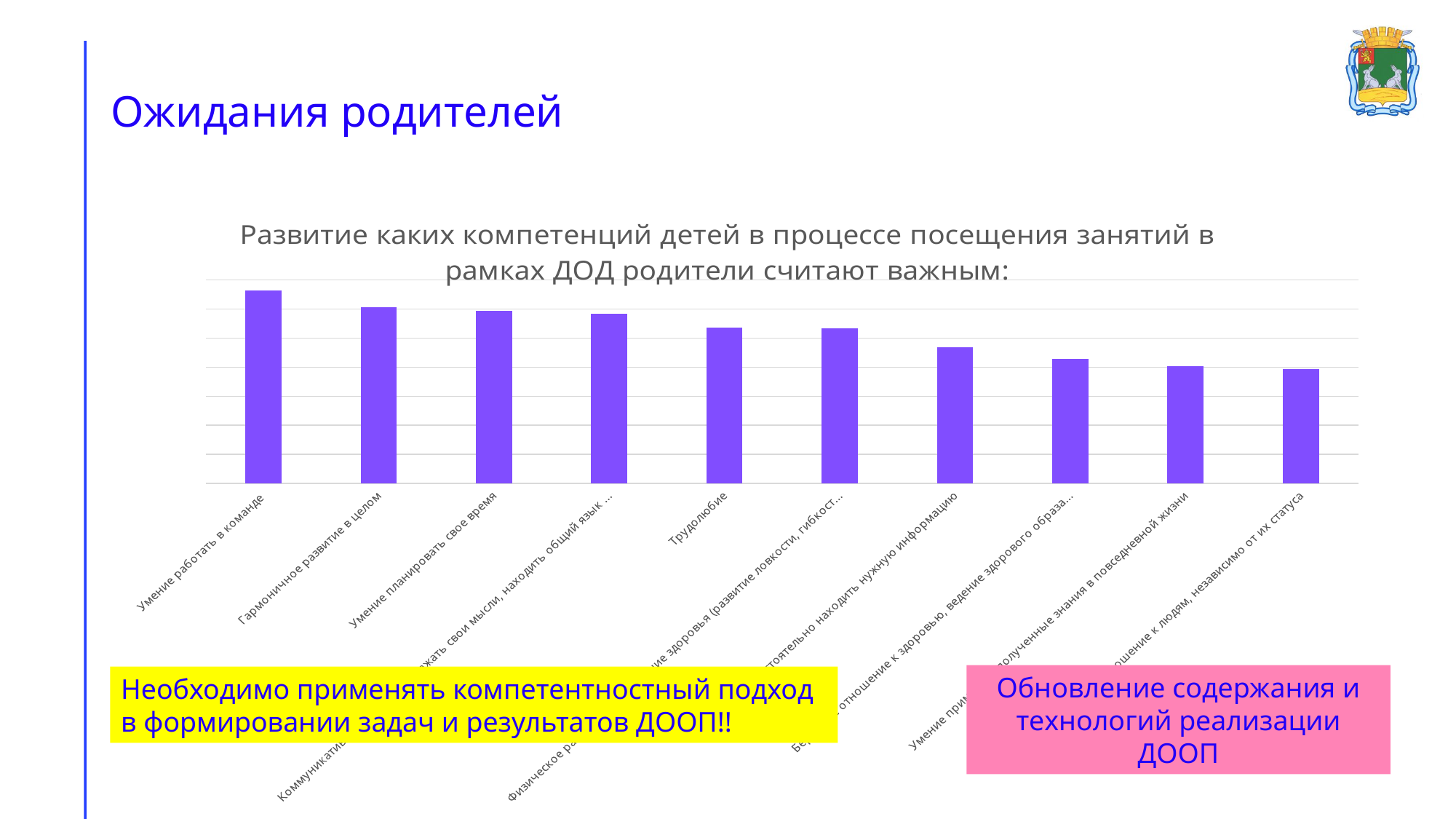
Do the bar values rise or fall from left to right along the x axis? Fall Which is larger: the value for "Умение работать в команде" or the value for "Трудолюбие"? Умение работать в команде Which is larger: the value for "Гармоничное развитие в целом" or the value for "Трудолюбие"? Гармоничное развитие в целом What kind of chart is shown on the slide? Bar chart How many categories (bars) does the chart show? 10 Which is larger: the value for "Умение планировать свое время" or the value for "Трудолюбие"? Умение планировать свое время What colour are the bars in the chart? Purple Which category has the highest value in the chart? Умение работать в команде What is the title of the chart? Развитие каких компетенций детей в процессе посещения занятий в рамках ДОД родители считают важным: